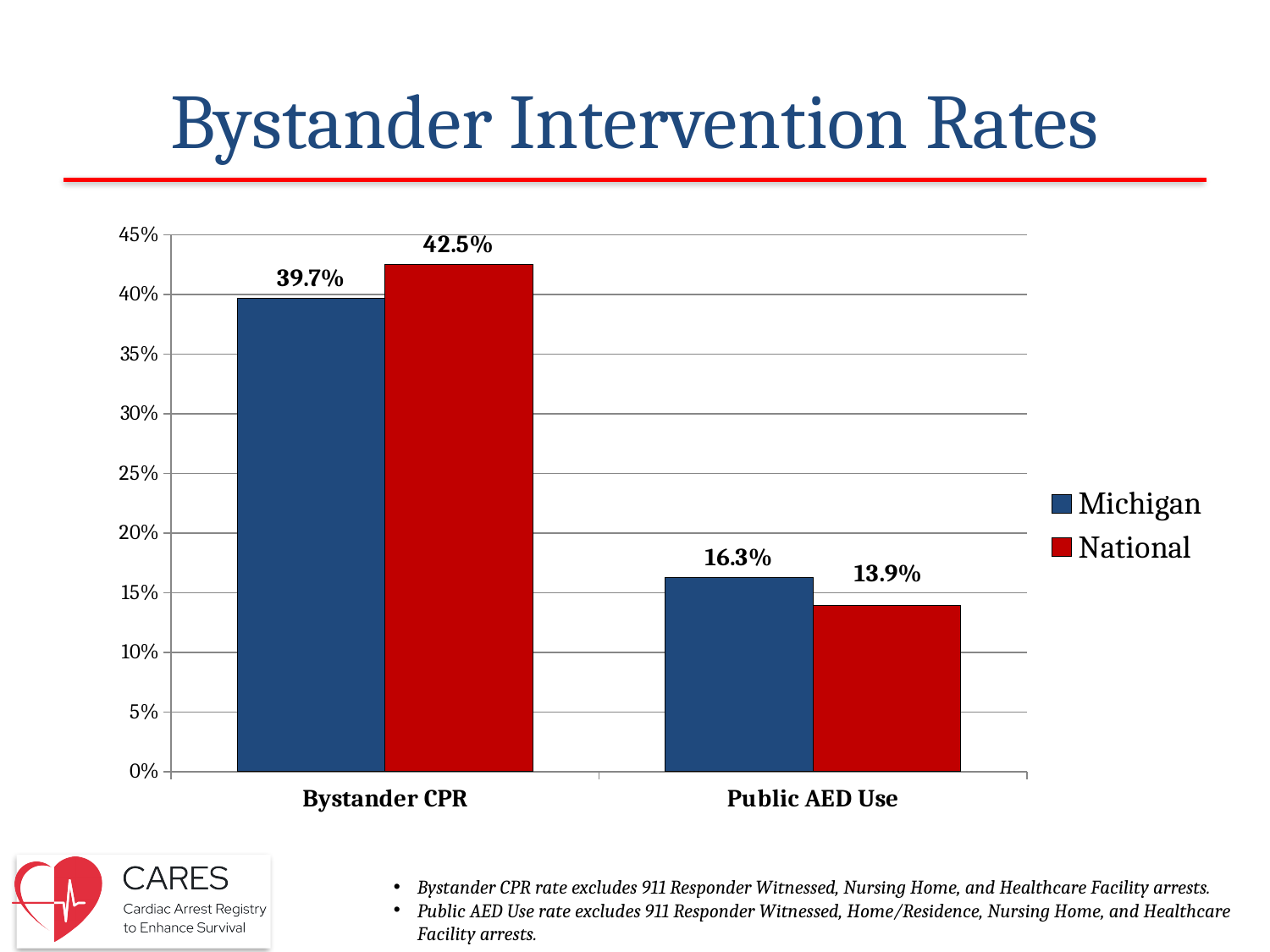
Which series has the higher value for Public AED Use, Michigan or National? Michigan Which bar has the highest value in the chart? National, Bystander CPR (42.5%) What is the Michigan value for Public AED Use? 16.3% Which series has the higher value for Bystander CPR, Michigan or National? National Which bar has the lowest value in the chart? National, Public AED Use (13.9%) What is the difference between the National and Michigan values for Bystander CPR? 2.8% What is the National value for Public AED Use? 13.9% What is the National value for Bystander CPR? 42.5% What is the Michigan value for Bystander CPR? 39.7% How many series does the legend list? 2 What is the difference between the Michigan and National values for Public AED Use? 2.4% What type of chart is shown on the slide? Bar chart